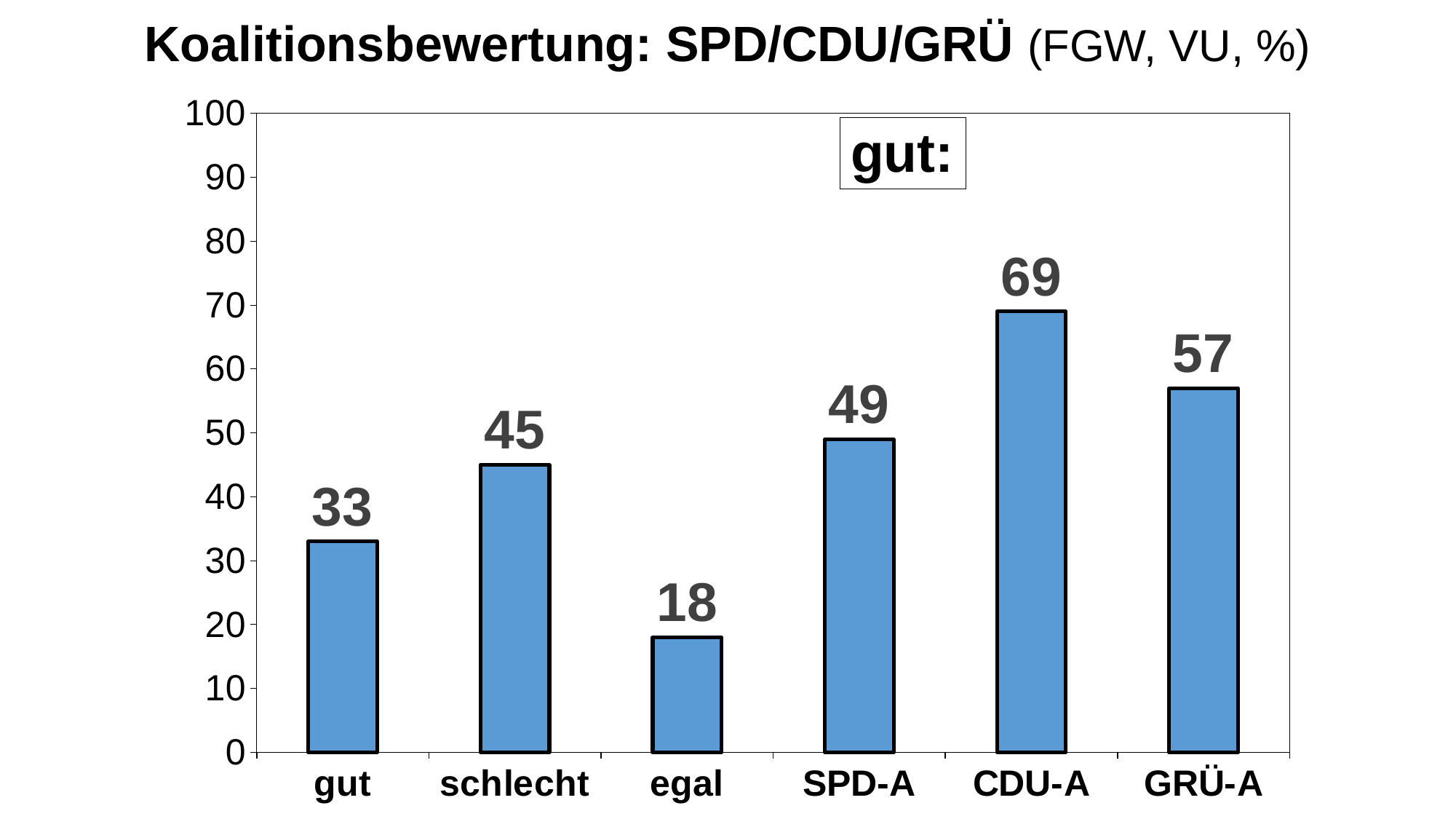
What is the difference between the values for "schlecht" and "gut"? 12 What is the value for "egal"? 18 What is the difference between the values for CDU-A and SPD-A? 20 What kind of chart is shown on the slide? bar chart What is the value for "schlecht"? 45 Which category has the highest value? CDU-A Is the value for GRÜ-A greater or less than 50? greater What is the value for CDU-A? 69 What is the title of the chart? Koalitionsbewertung: SPD/CDU/GRÜ (FGW, VU, %) How many categories are shown on the x axis? 6 Which is larger, the value for GRÜ-A or the value for SPD-A? GRÜ-A Which category has the lowest value? egal